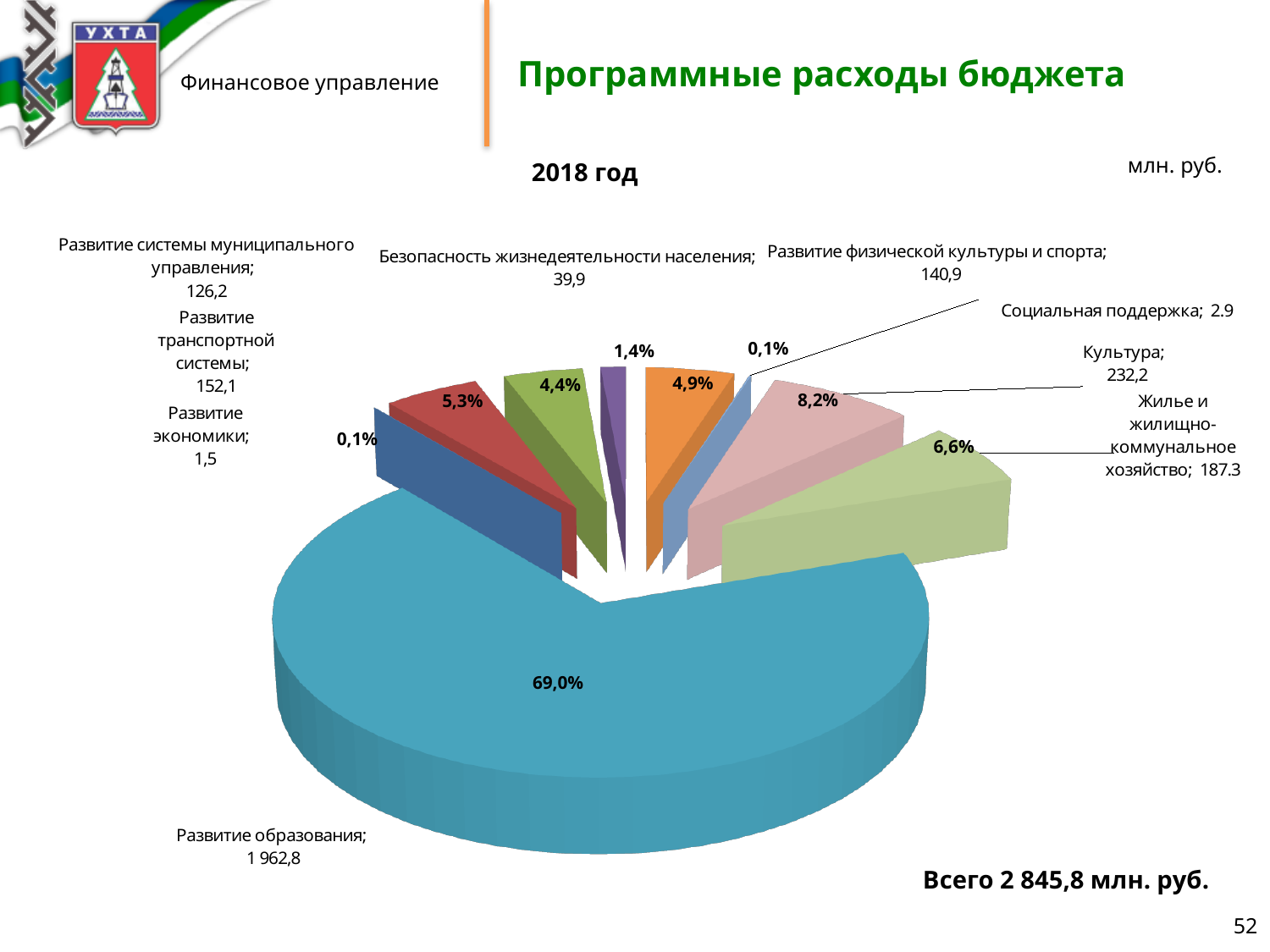
What is the value for Культура? 232,2 How many categories does the pie chart show? 9 What total is stated for the programme expenditures on the slide? 2 845,8 млн. руб. What is the value for Развитие транспортной системы? 152,1 What kind of chart is shown on the slide? Pie chart What share of the pie does Культура take? 8,2% What share of the pie does Развитие образования take? 69,0% What is the value for Развитие образования? 1 962,8 Which category has the largest value? Развитие образования Which category has the smallest value? Развитие экономики Which is larger, Культура or Жилье и жилищно-коммунальное хозяйство? Культура What is the difference between Развитие транспортной системы and Развитие системы муниципального управления? 25,9